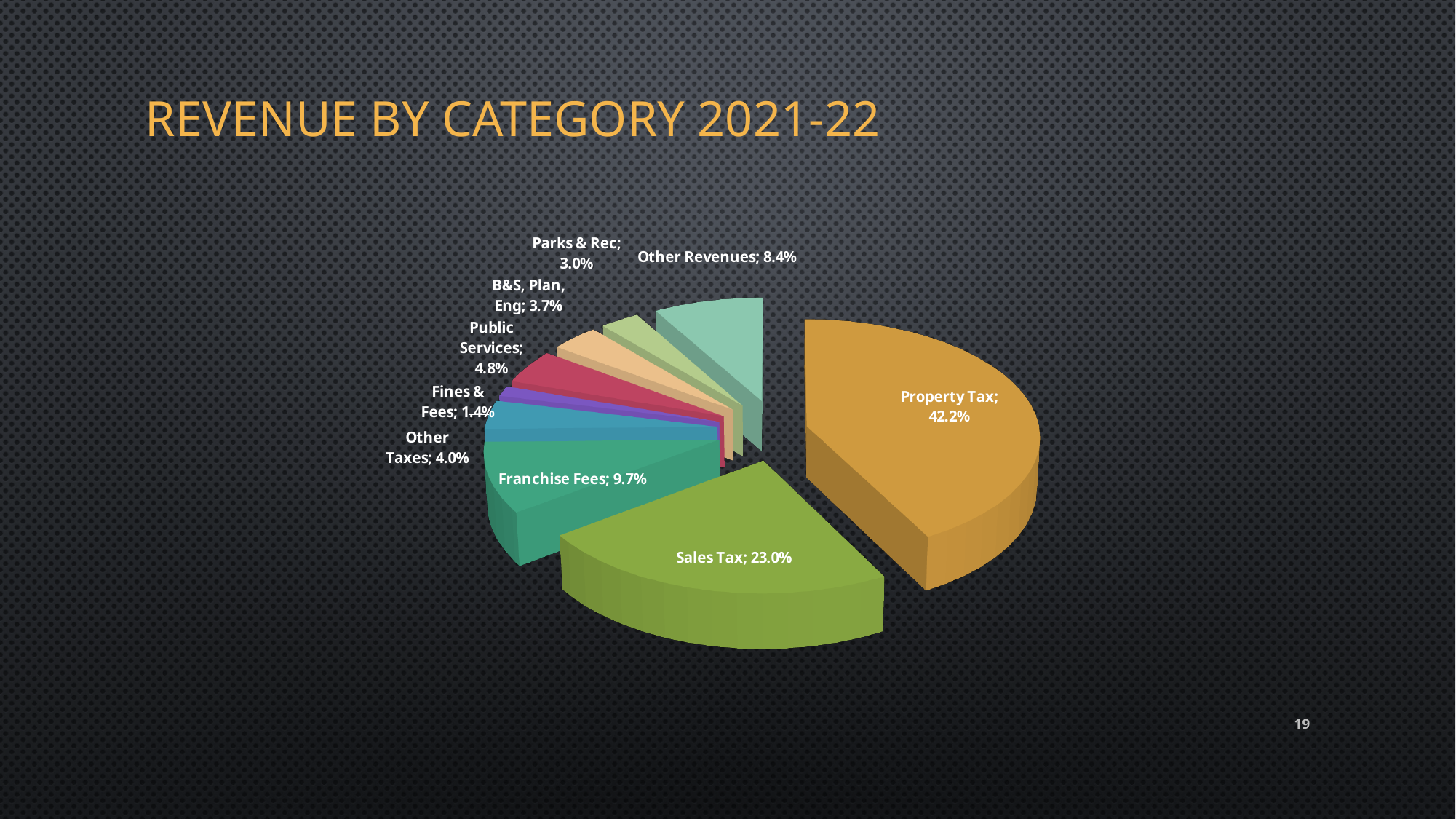
What share of revenue does Property Tax account for? 42.2% What type of chart is shown on the slide? Pie chart Which is larger, Public Services or Other Taxes? Public Services What share of revenue comes from Fines & Fees? 1.4% What percentage is shown for Other Revenues? 8.4% How many categories are shown in the pie chart? 9 Which revenue category has the smallest share? Fines & Fees What is the difference in percentage points between Property Tax and Sales Tax? 19.2 What is the title of the chart? Revenue by Category 2021-22 What is the share for Franchise Fees? 9.7% Which revenue category has the largest share? Property Tax What percentage of revenue comes from Sales Tax? 23.0%